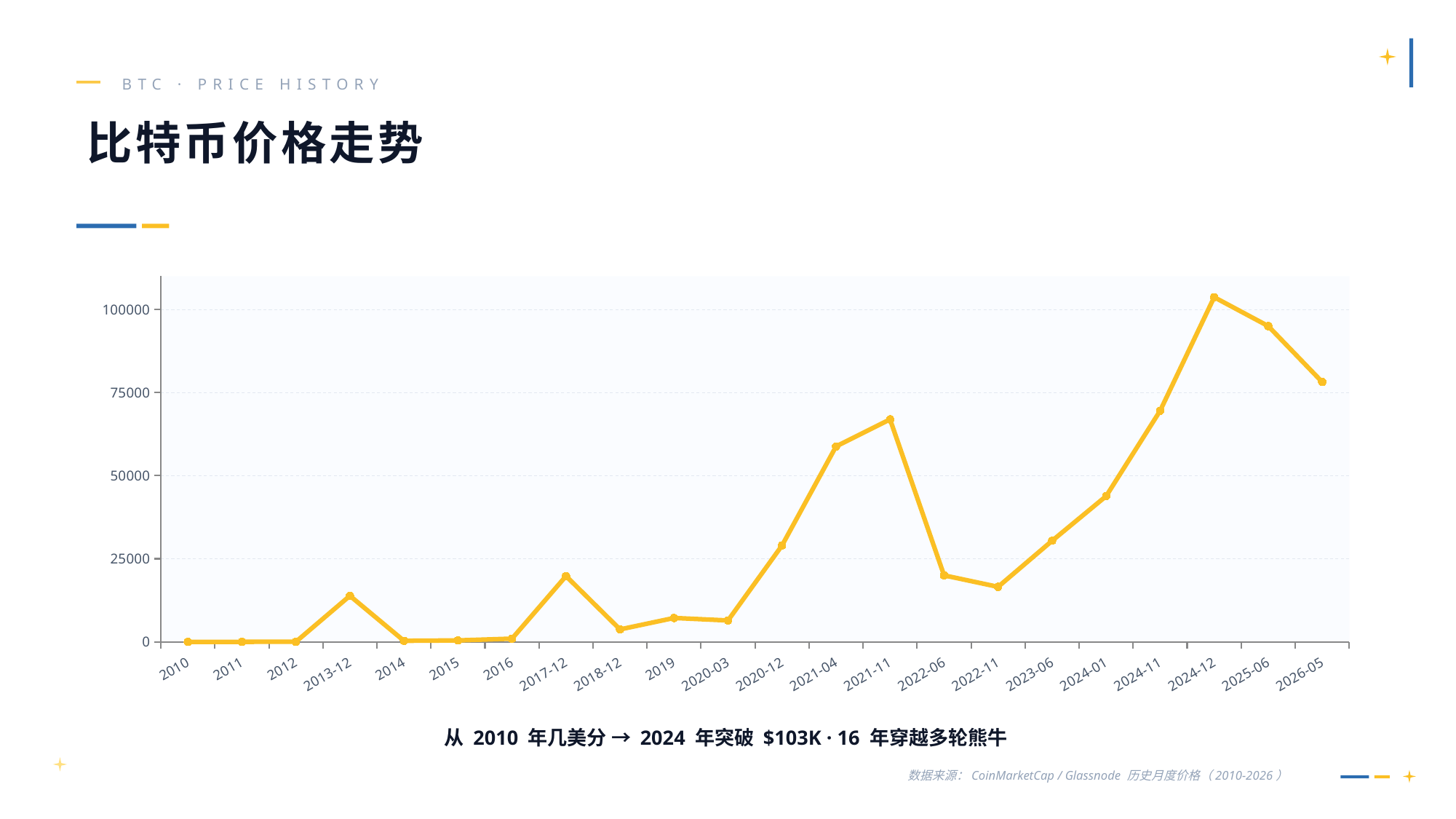
Which is larger, the value for 2021-04 or the value for 2021-11? 2021-11 Do the values rise or fall from 2024-12 to 2026-05? fall Is the value for 2024-12 greater or less than 100000? greater Is the value for 2024-11 greater or less than 75000? less Which is larger, the value for 2013-12 or the value for 2017-12? 2017-12 What is the title of the slide containing the chart? 比特币价格走势 Which date on the x axis has the highest Bitcoin price? 2024-12 What kind of chart is shown on the slide? line chart Is the value for 2022-11 greater or less than 25000? less How many data points are plotted on the line chart? 22